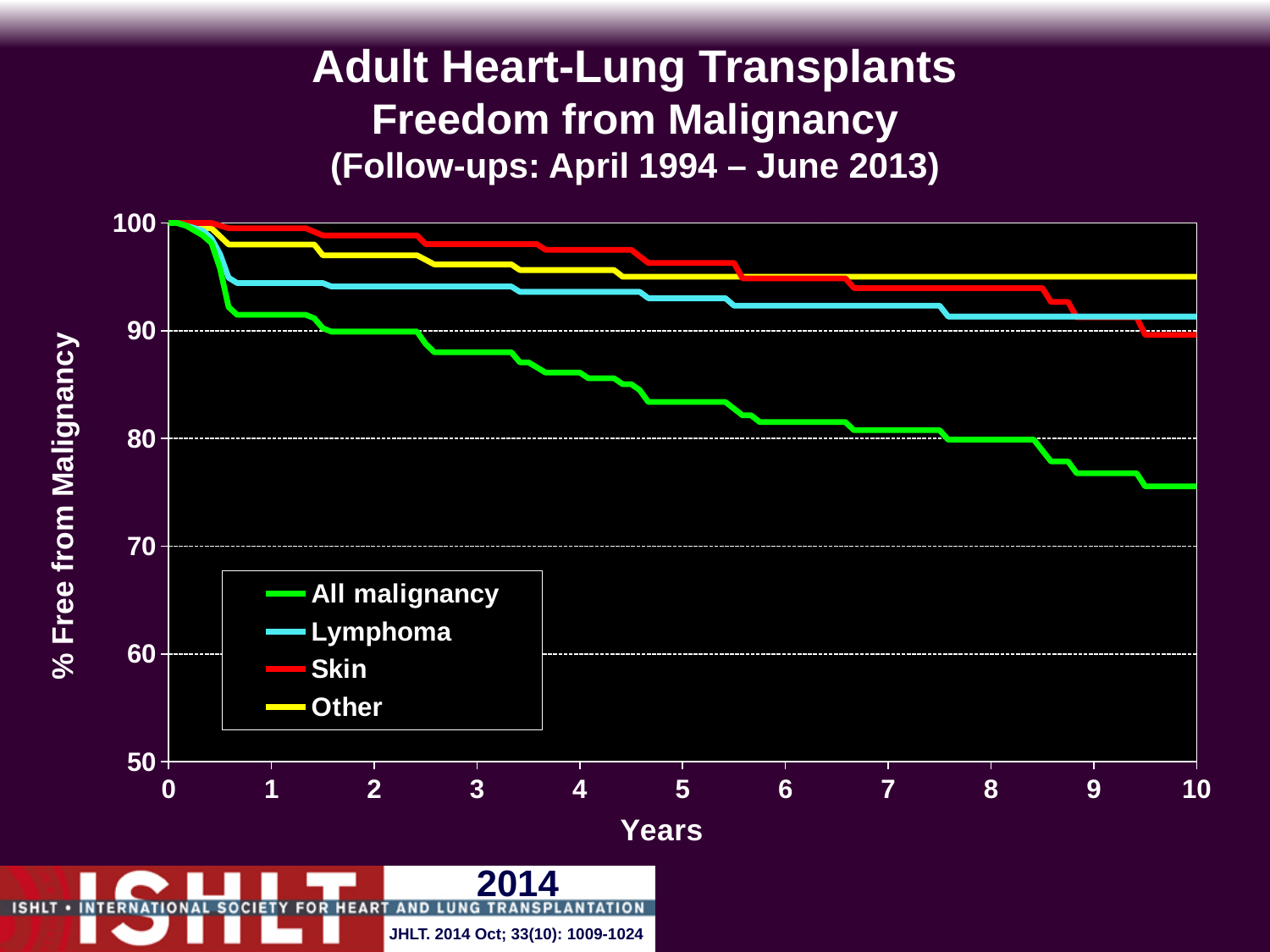
What kind of chart is shown on the slide? Line chart Is the value for Other at 10 years greater or less than 90? greater Is the value for Lymphoma at 10 years greater or less than 90? greater Is the value for All malignancy at 10 years greater or less than 80? less At 2 years, which is higher: Skin or Lymphoma? Skin At 10 years, which is higher: Lymphoma or All malignancy? Lymphoma Which series has the lowest value at 10 years? All malignancy Do the values for All malignancy rise or fall as years increase? Fall What is the label of the y axis? % Free from Malignancy How many series does the legend list? 4 Which series has the highest value at 10 years? Other